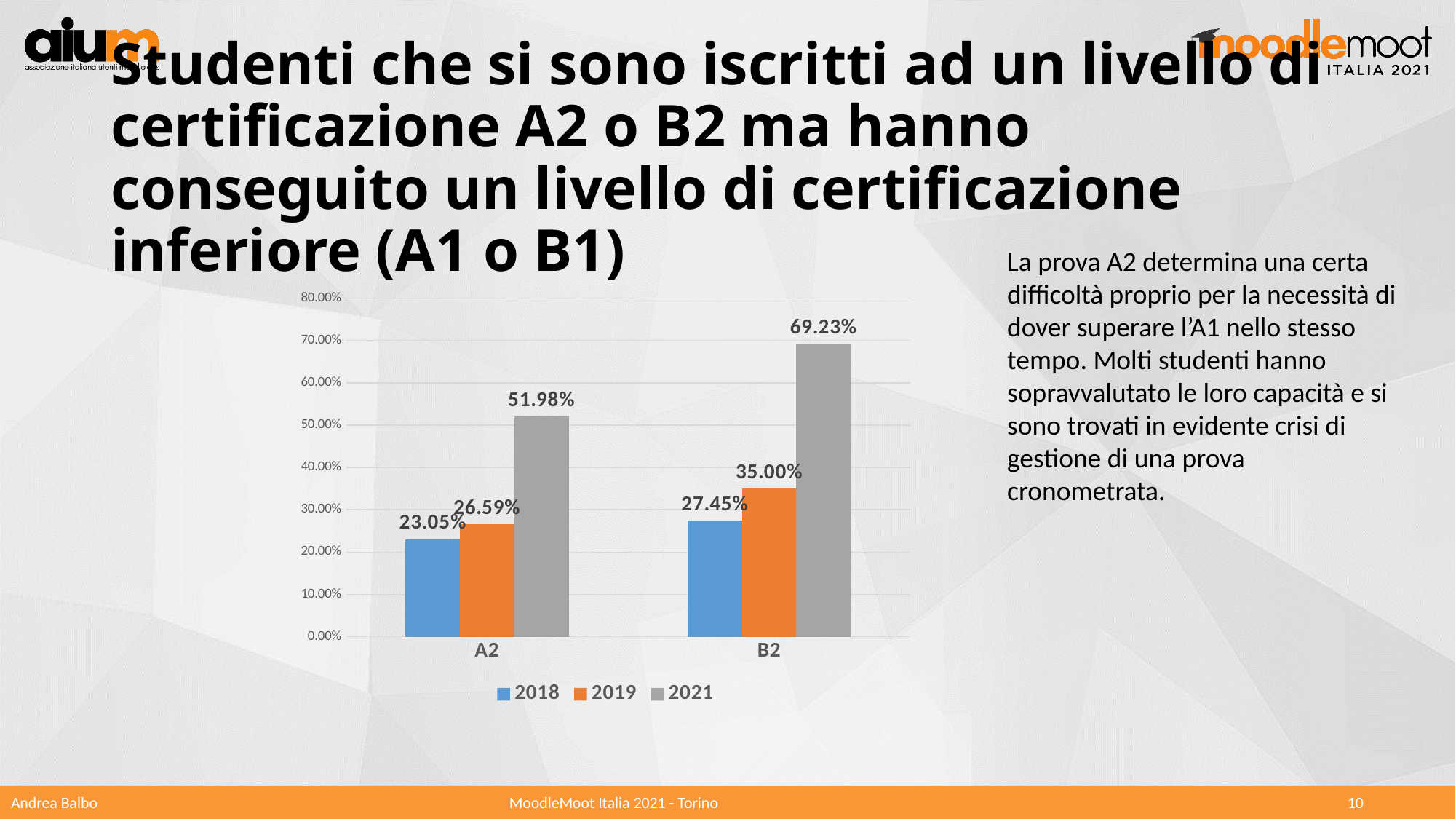
What is the value for 2018 in the B2 category? 27.45% How many series does the legend list? 3 What is the difference between the 2021 values for B2 and A2? 17.25% What is the value for 2018 in the A2 category? 23.05% Which is larger: the 2019 value for A2 or the 2019 value for B2? B2 What is the value for 2019 in the B2 category? 35.00% What is the value for 2021 in the A2 category? 51.98% Is the 2021 value for B2 greater or less than 60.00%? greater How many categories are shown on the x axis? 2 What kind of chart is shown on the slide? bar chart Which series has the lowest value in the A2 category? 2018 Which series has the highest value in the B2 category? 2021